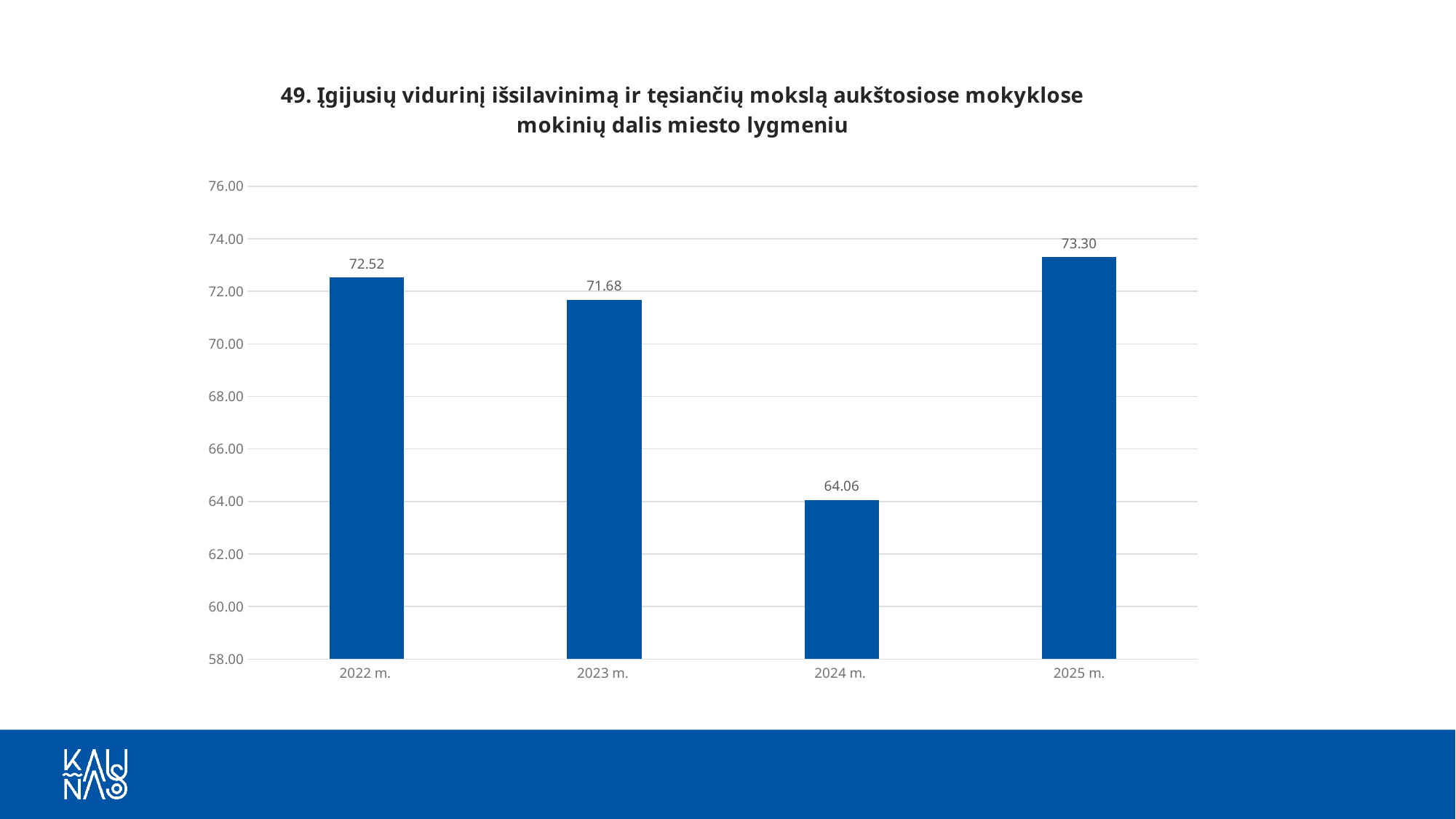
Which year has the lowest value? 2024 m. What is the difference between the values for 2025 m. and 2024 m.? 9.24 What is the difference between the values for 2022 m. and 2023 m.? 0.84 What kind of chart is shown on the slide? bar chart Which year has the highest value? 2025 m. Which is larger, the value for 2022 m. or the value for 2023 m.? 2022 m. What is the value for 2022 m.? 72.52 How many years are shown on the chart? 4 What is the value for 2024 m.? 64.06 Does the value rise or fall from 2024 m. to 2025 m.? rise Is the value for 2024 m. greater or less than 66.00? less What is the value for 2025 m.? 73.30